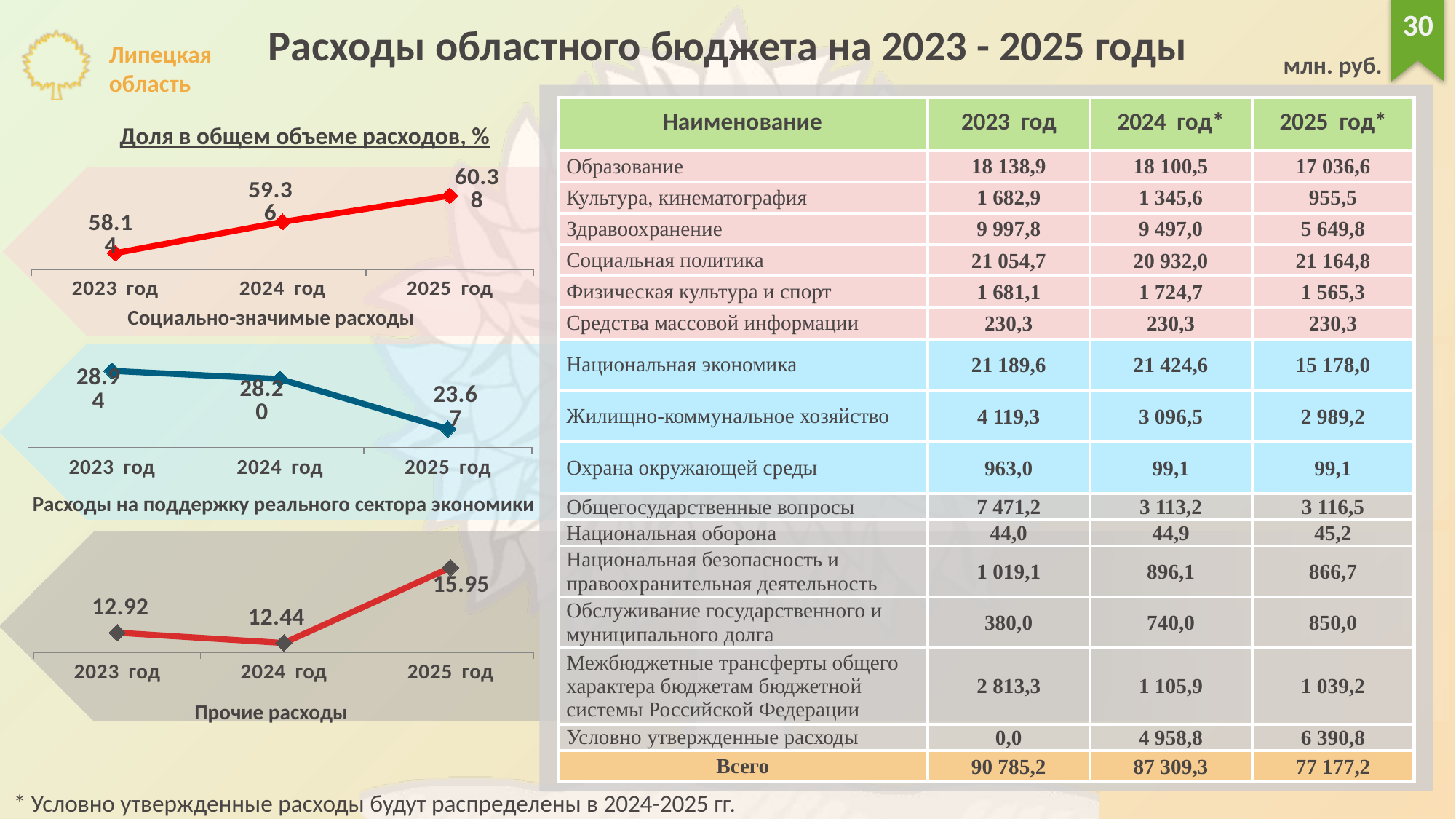
In the 'Прочие расходы' chart, what is the difference between the 2025 год and 2024 год values? 3.51 In the 'Прочие расходы' chart, what is the value for 2025 год? 15.95 In the 'Расходы на поддержку реального сектора экономики' chart, which year has the lowest value? 2025 год How many data points are plotted in the 'Прочие расходы' chart? 3 In the 'Социально-значимые расходы' chart, do the values rise or fall from 2023 год to 2025 год? rise In the 'Расходы на поддержку реального сектора экономики' chart, do the values rise or fall from 2023 год to 2025 год? fall In the 'Прочие расходы' chart, which year has the highest value? 2025 год In the 'Прочие расходы' chart, which year has the lowest value? 2024 год In the 'Социально-значимые расходы' chart, which is larger, the value for 2023 год or 2025 год? 2025 год What type of chart is 'Социально-значимые расходы'? line chart In the 'Прочие расходы' chart, what is the value for 2023 год? 12.92 In the 'Прочие расходы' chart, what is the value for 2024 год? 12.44